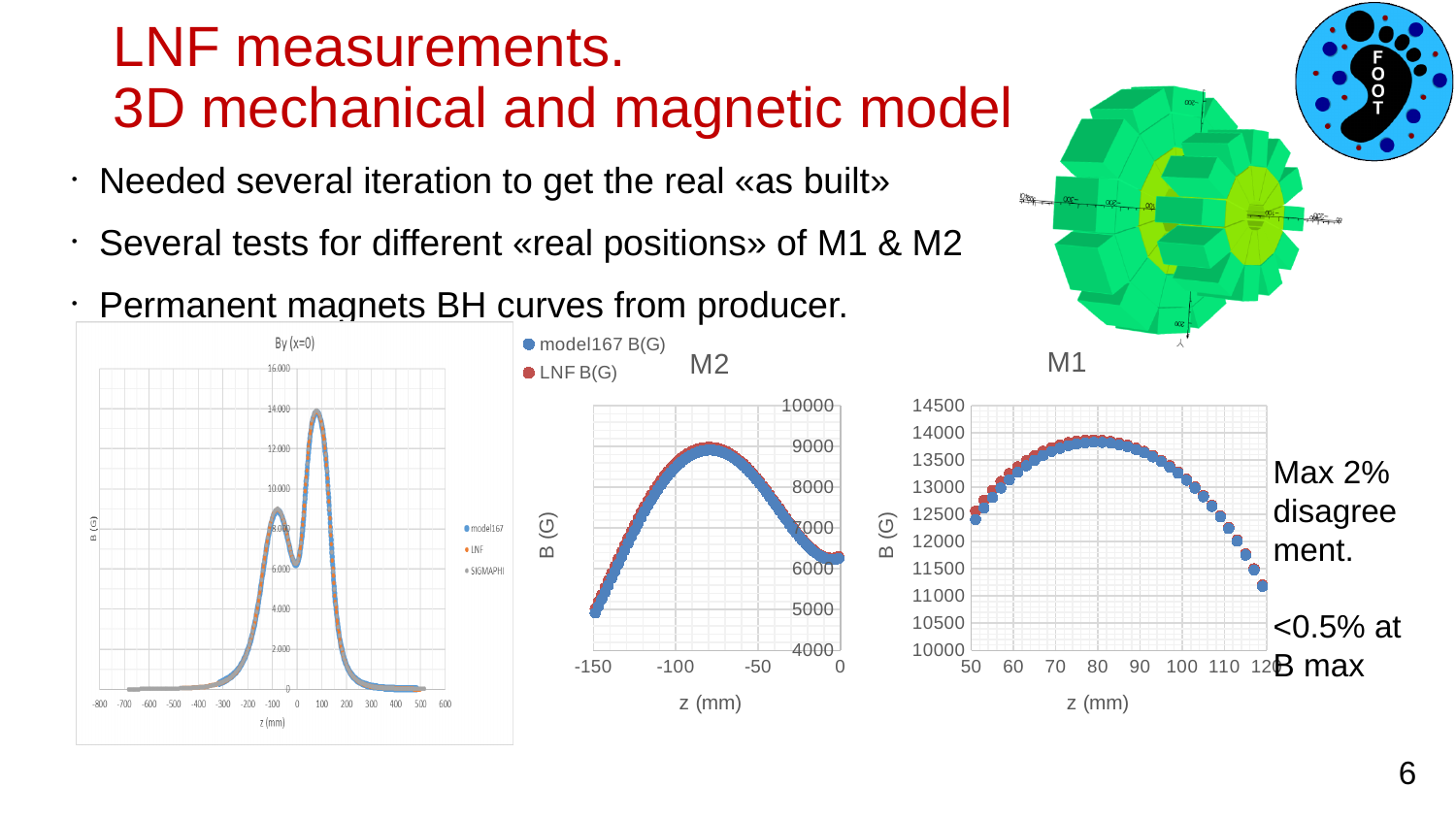
What is the title of the chart on the left of the slide? By (x=0) In the left chart (By (x=0)), is the highest peak value greater or less than 12.000 G? greater In the M1 chart, is the maximum value of B greater or less than 13500 G? greater In the left chart (By (x=0)), is the smaller peak near z = -100 mm greater or less than 10.000 G? less What are the two legend entries of the M2 chart? model167 B(G) and LNF B(G) How many series does the legend of the left chart (By (x=0)) list? 3 How many series does the legend of the M2 chart list? 2 What kind of chart is the M1 chart? scatter chart In the M1 chart, which is larger: the value of B at z = 50 mm or at z = 120 mm? z = 50 mm